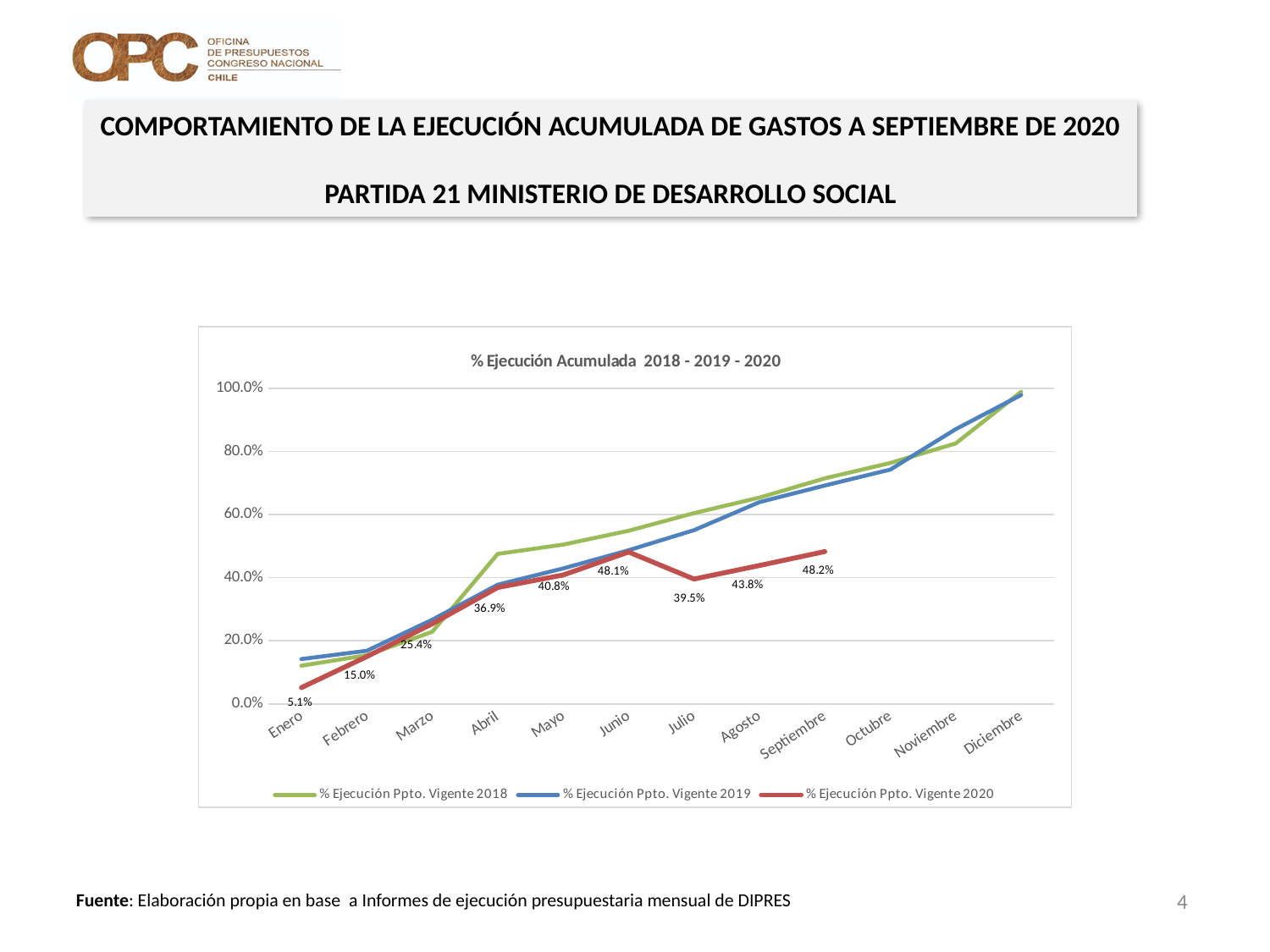
What kind of chart is shown on the slide? line chart What is the value of % Ejecución Ppto. Vigente 2020 for Septiembre? 48.2% Is the value of % Ejecución Ppto. Vigente 2019 for Diciembre greater or less than 80.0%? greater Which month has the lowest value for % Ejecución Ppto. Vigente 2020? Enero How many months are shown on the x axis? 12 What is the difference between the % Ejecución Ppto. Vigente 2020 values for Junio and Julio? 8.6% For % Ejecución Ppto. Vigente 2020, is the value for Abril larger than the value for Marzo? Yes What is the value of % Ejecución Ppto. Vigente 2020 for Enero? 5.1% What is the value of % Ejecución Ppto. Vigente 2020 for Julio? 39.5% Does the % Ejecución Ppto. Vigente 2018 line rise or fall from Enero to Diciembre? rise What is the title of the chart? % Ejecución Acumulada 2018 - 2019 - 2020 How many series does the legend list? 3